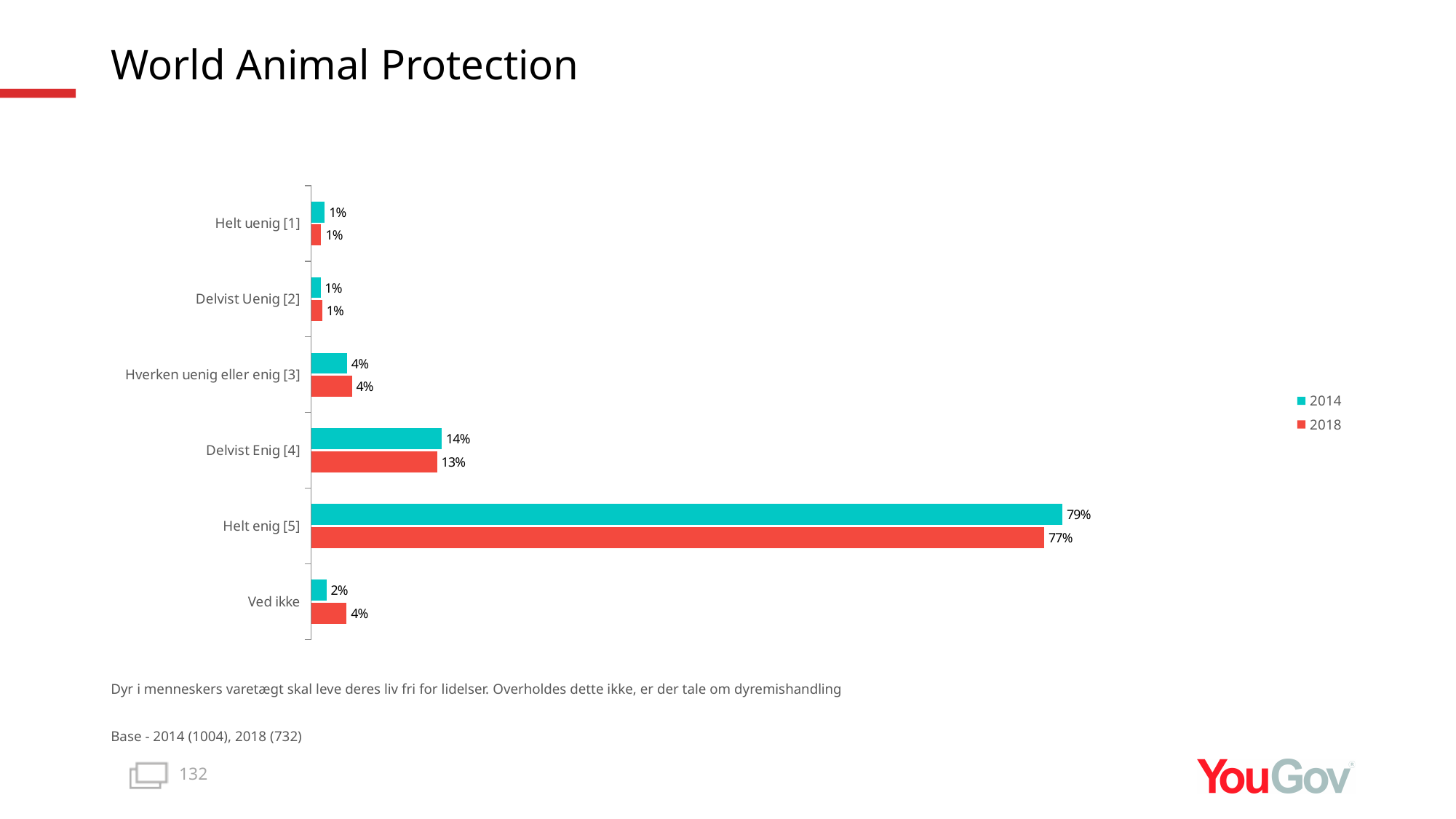
Which category has the highest 2018 value? Helt enig [5] What is the 2018 value for Ved ikke? 4% What is the 2014 value for Helt enig [5]? 79% Which colour represents the 2018 series? Red How many categories are shown on the chart? 6 Which is larger for Delvist Enig [4]: the 2014 value or the 2018 value? 2014 What kind of chart is shown on the slide? Bar chart What is the 2018 value for Delvist Enig [4]? 13% Which is larger for Ved ikke: the 2014 value or the 2018 value? 2018 How many series does the legend list? 2 What is the difference between the 2018 and 2014 values for Ved ikke? 2% What is the difference between the 2014 and 2018 values for Helt enig [5]? 2%